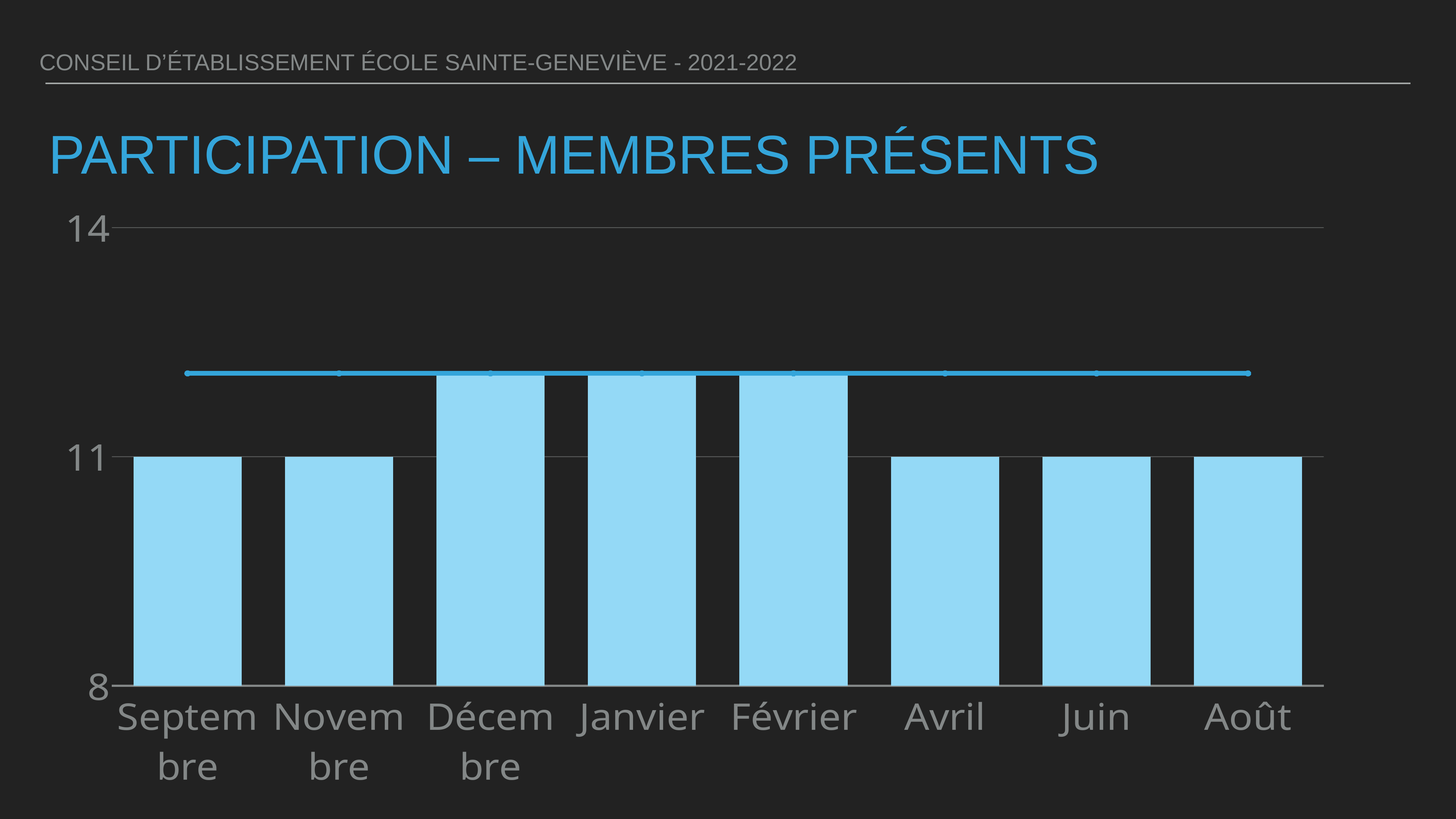
Is the value for Janvier greater or less than 14? less How many months are shown on the x axis of the chart? 8 What is the value for Avril? 11 Which is larger, the value for Novembre or the value for Décembre? Décembre Is the value for Décembre greater or less than 11? greater What is the title of the chart? PARTICIPATION – MEMBRES PRÉSENTS What is the value for Septembre? 11 What is the lowest value shown on the y axis? 8 What is the value for Juin? 11 Which is larger, the value for Février or the value for Avril? Février What is the value for Août? 11 What kind of chart is shown on the slide? combination bar and line chart